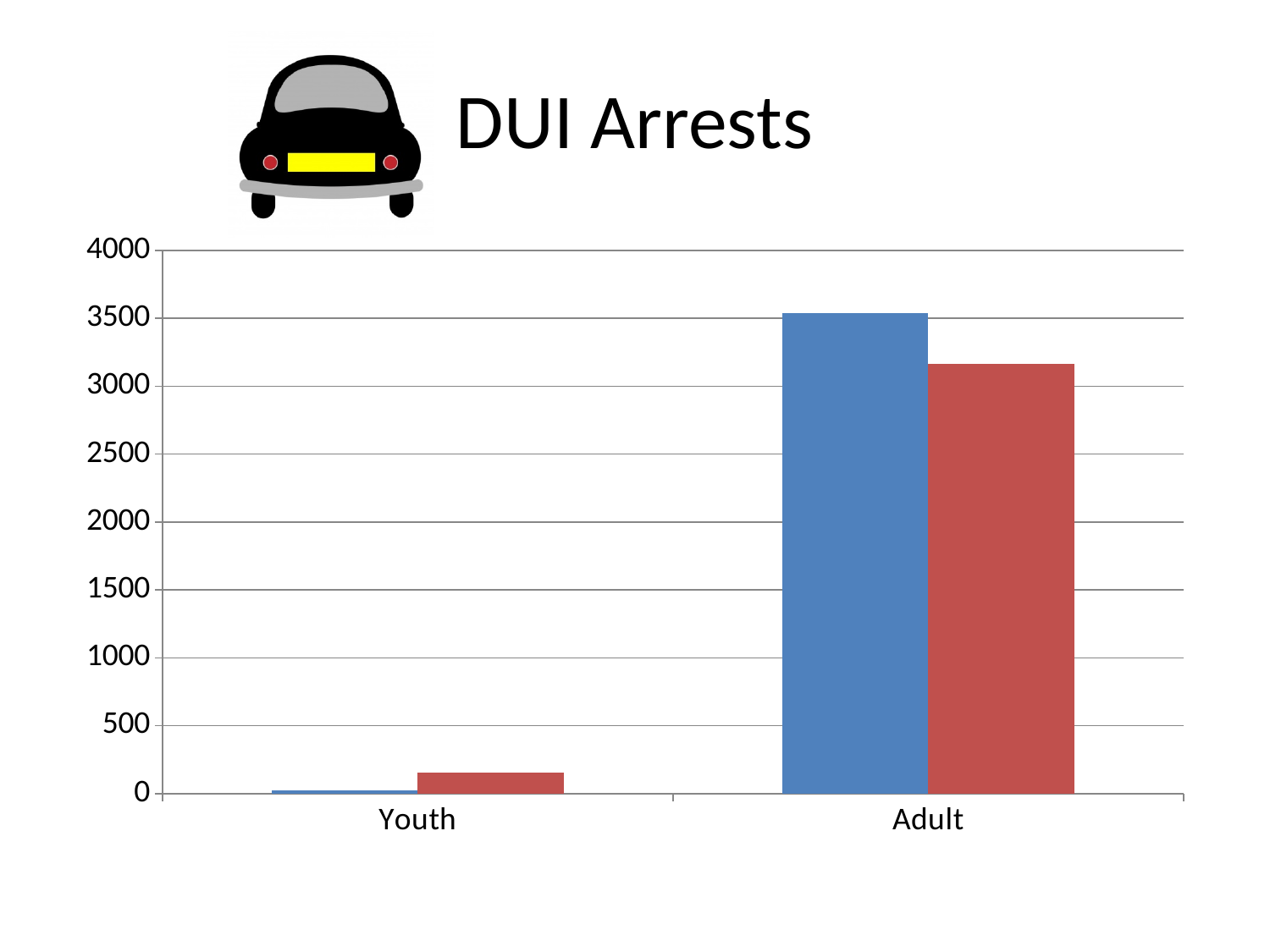
How many categories are shown on the x axis of the chart? 2 What is the title of the chart? DUI Arrests What kind of chart is shown on the slide? bar chart Is the value of the red bar for Youth greater or less than 500? less Which category has the highest bars in the chart? Adult For the Adult category, which bar is larger, the blue bar or the red bar? the blue bar Is the value of the blue bar for Adult greater or less than 3000? greater What is the highest value shown on the y axis of the chart? 4000 Is the value of the red bar for Adult greater or less than 3000? greater For the Youth category, which bar is larger, the blue bar or the red bar? the red bar Which category has the lowest bars in the chart? Youth